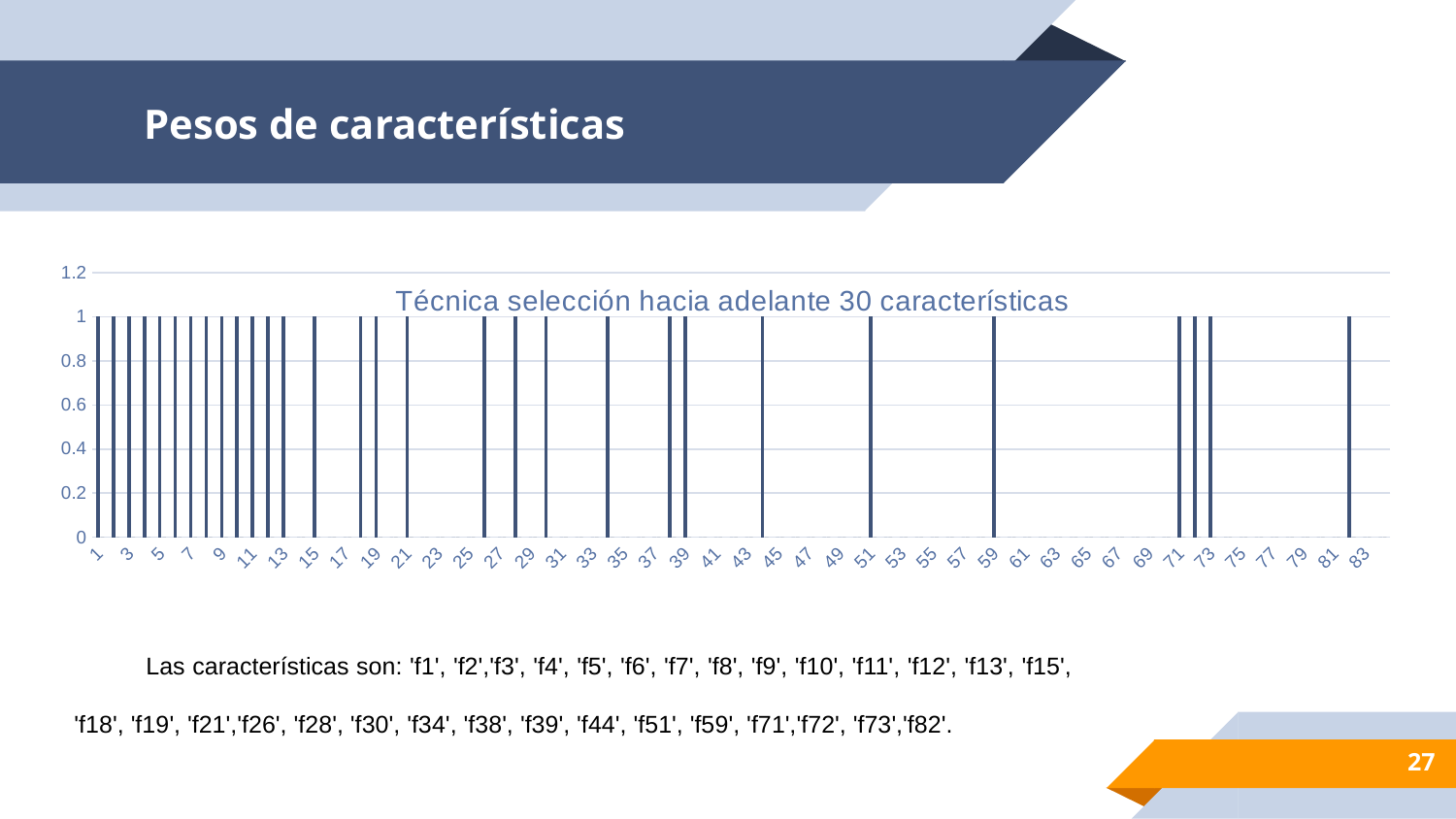
What is the highest tick value shown on the y axis? 1.2 Is the value for category 17 greater or less than 0.2? less How many bars with a value of 1 are plotted in the chart? 30 What is the value of the bar for category 59? 1 What is the last category label shown on the x axis? 83 What is the difference between the value for category 15 and the value for category 16? 1 What is the title printed inside the chart? Técnica selección hacia adelante 30 características Which is larger, the value for category 13 or the value for category 14? 13 What is the value for category 14? 0 What is the value of the bar for category 15? 1 What kind of chart is shown on the slide? bar chart Is the value for category 19 greater or less than 0.6? greater